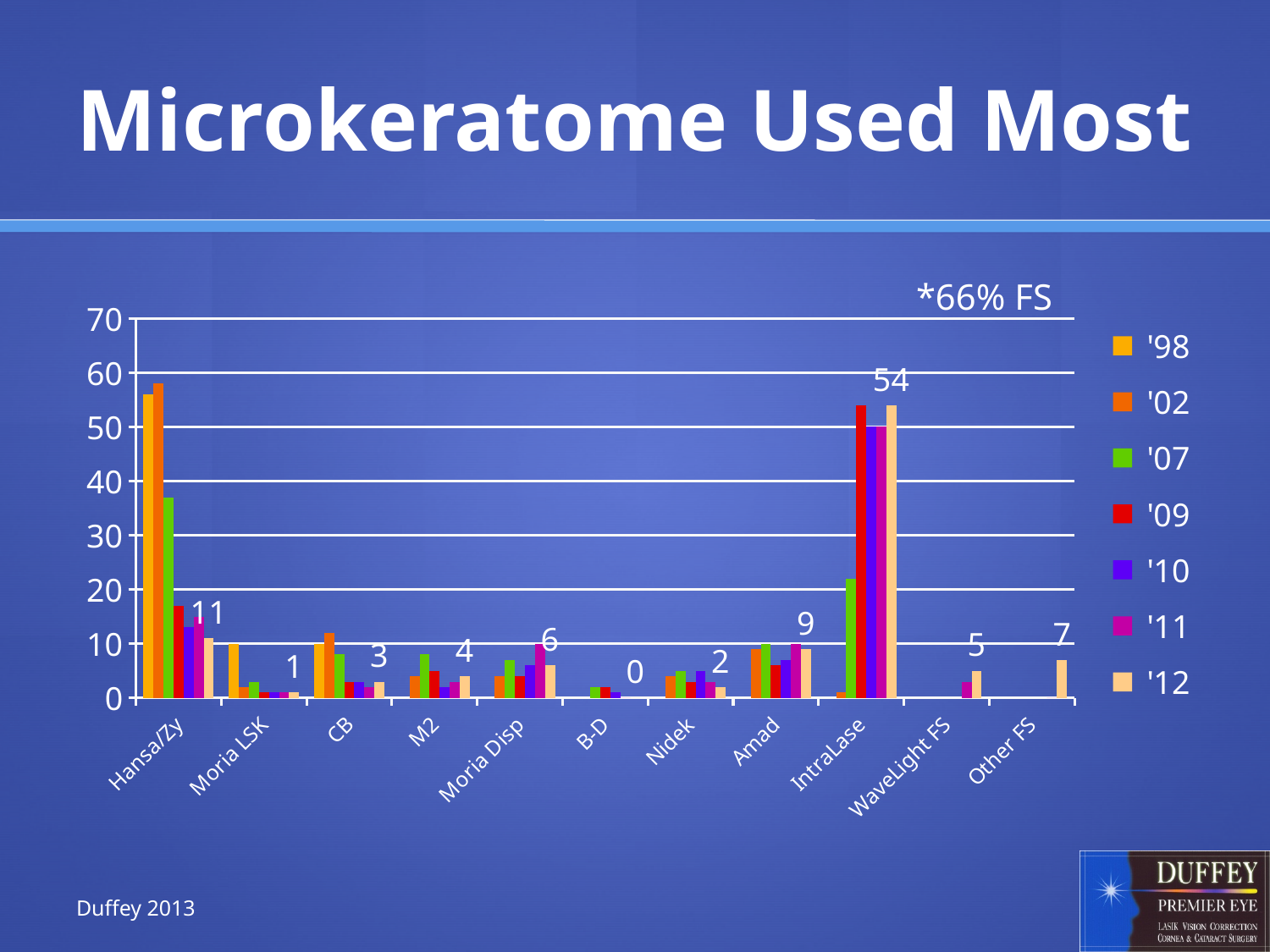
What is the '12 value for B-D? 0 Is the '07 value for Hansa/Zy greater or less than 40? less How many categories are shown on the x axis? 11 What is the '12 value for IntraLase? 54 What is the difference between the '12 values for IntraLase and Amad? 45 What is the '12 value for Hansa/Zy? 11 What kind of chart is shown on the slide? bar chart What is the '12 value for Other FS? 7 Which has the larger '12 value, WaveLight FS or Other FS? Other FS Which category has the highest '12 value? IntraLase Which category has the lowest '12 value? B-D How many series does the legend list? 7